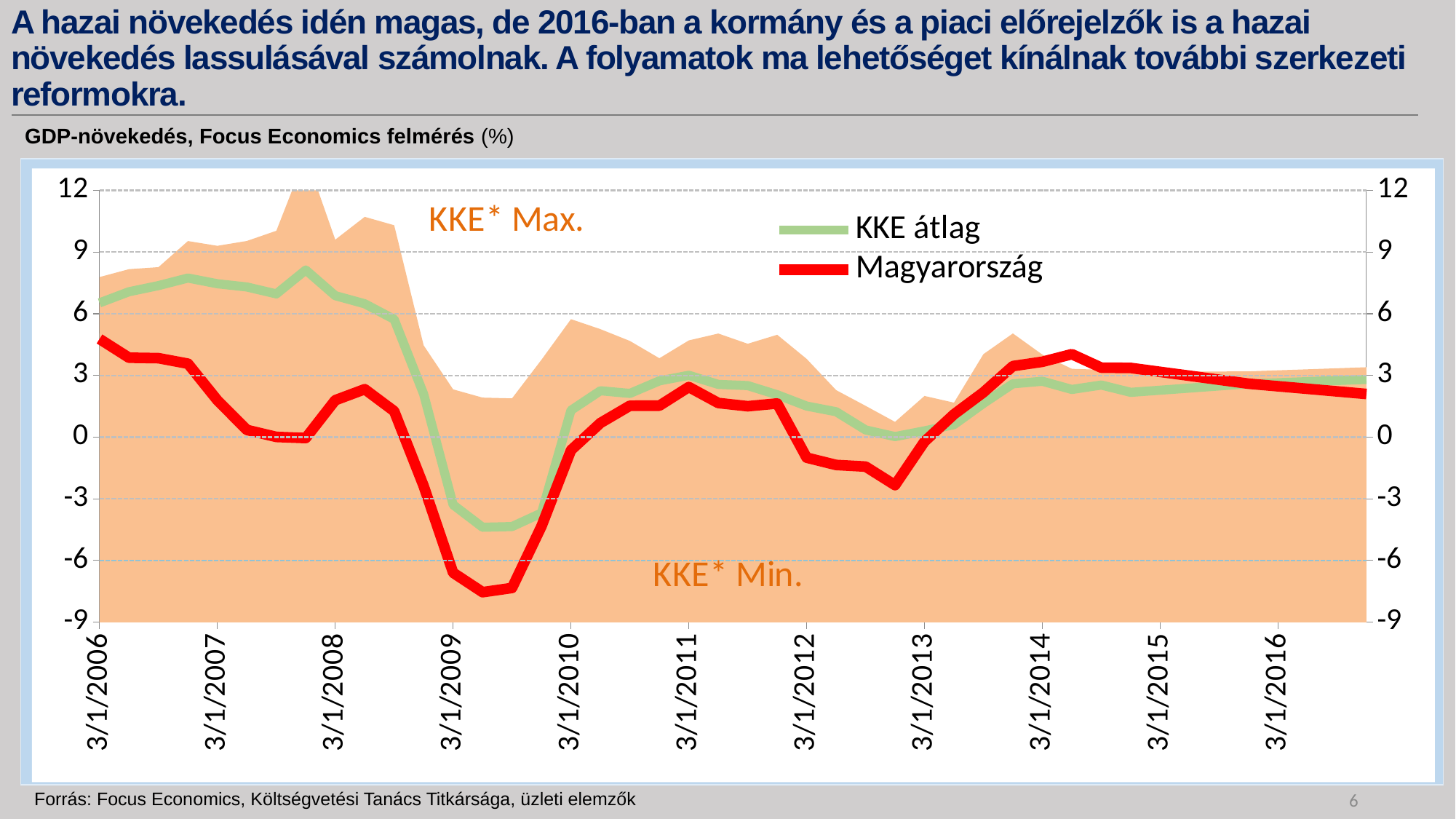
Does the Magyarország line rise or fall between 3/1/2006 and 3/1/2009? fall Is the value for Magyarország at 3/1/2009 greater or less than -6? less Is the value for KKE átlag at 3/1/2008 greater or less than 6? greater At 3/1/2006, which series has the higher value, KKE átlag or Magyarország? KKE átlag How many series does the chart legend list? 2 What kind of chart is shown on the slide? combination area and line chart Is the value for Magyarország at 3/1/2012 greater or less than 0? less What is the title of the chart? GDP-növekedés, Focus Economics felmérés (%) How many year labels are shown on the x axis? 11 In which year does the Magyarország line reach its lowest value? 2009 What colour is the Magyarország line in the chart? red